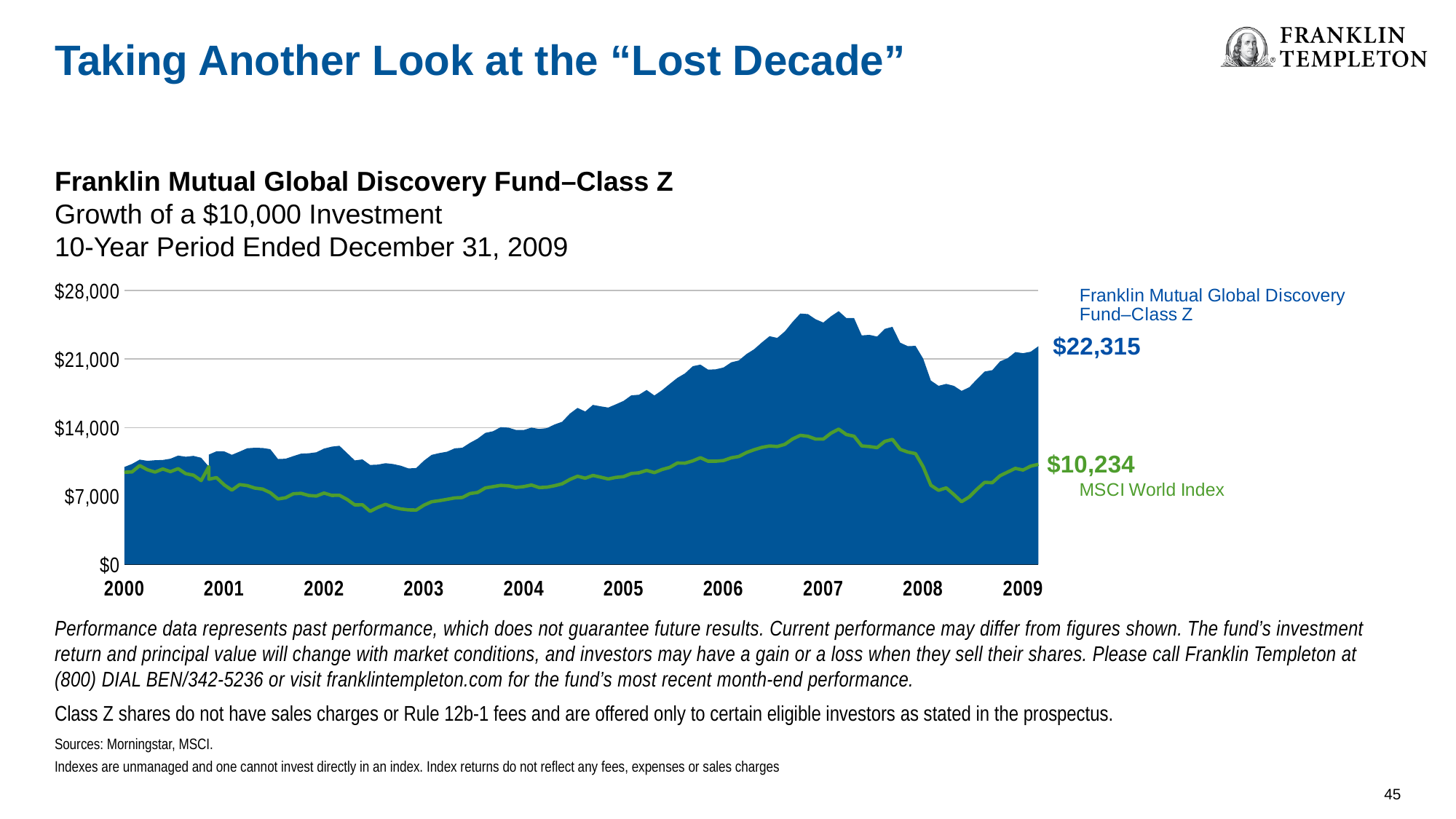
Is the peak value of the Franklin Mutual Global Discovery Fund–Class Z around 2007 greater or less than $21,000? greater What kind of chart is shown on the slide? area chart with a line What colour is the MSCI World Index line on the chart? green What is the difference between the ending values of the Franklin Mutual Global Discovery Fund–Class Z and the MSCI World Index? $12,081 Which ended the period with a higher value, the Franklin Mutual Global Discovery Fund–Class Z or the MSCI World Index? Franklin Mutual Global Discovery Fund–Class Z What is the highest value labeled on the y axis of the chart? $28,000 What is the ending value shown for the MSCI World Index? $10,234 How many series are plotted on the chart? 2 Is the value of the MSCI World Index at the start of 2003 greater or less than $7,000? less What is the ending value shown for the Franklin Mutual Global Discovery Fund–Class Z? $22,315 Did the value of the Franklin Mutual Global Discovery Fund–Class Z rise or fall between 2003 and 2007? rise How many years are labeled on the x axis of the chart? 10